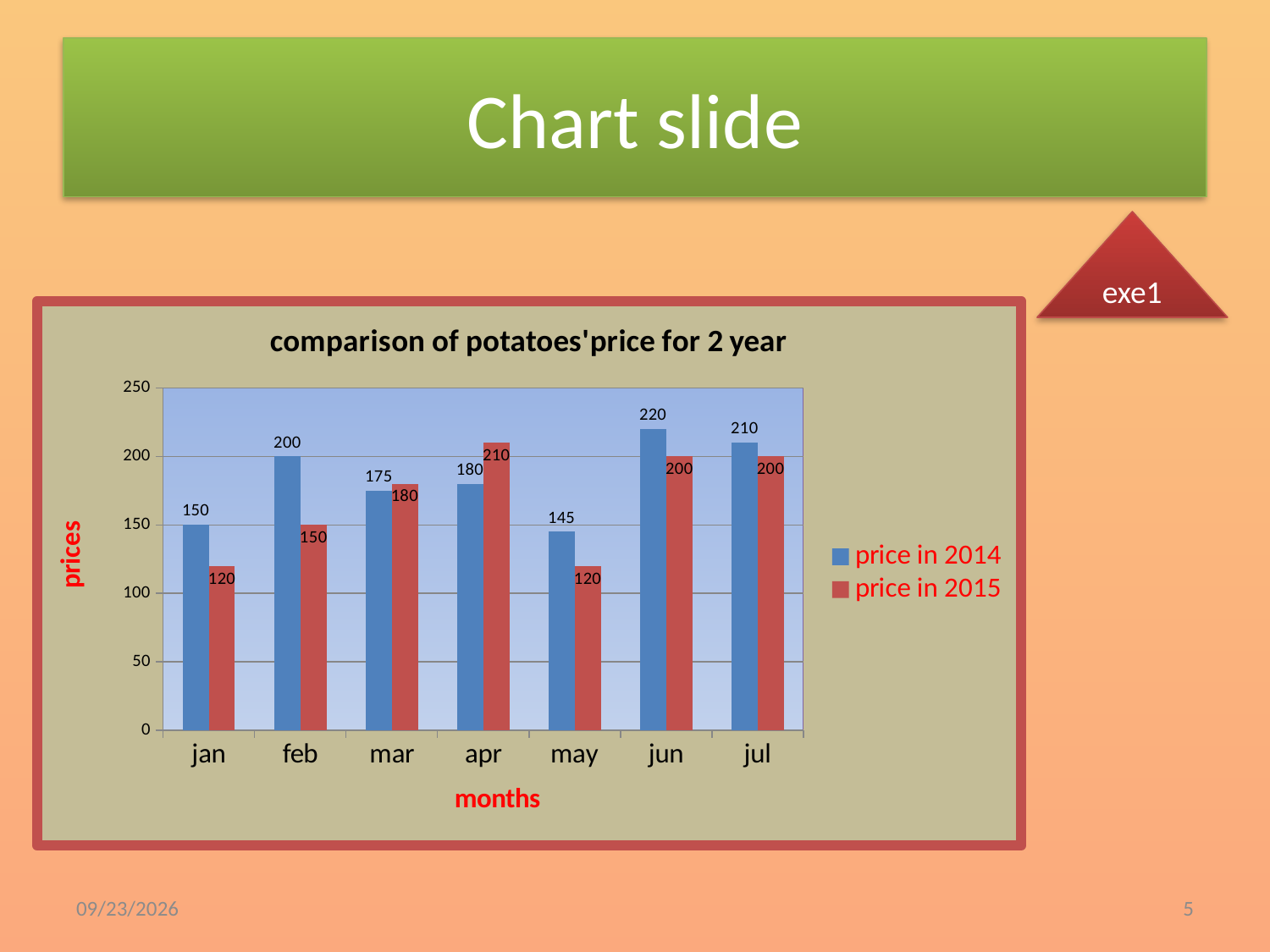
What is the title of the chart? comparison of potatoes'price for 2 year What is the label of the y axis? prices What kind of chart is shown on the slide? bar chart Which month has the highest price in 2014? jun What is the price in 2015 for may? 120 What is the price in 2015 for apr? 210 Which is larger for mar, the price in 2014 or the price in 2015? price in 2015 What is the price in 2014 for jan? 150 Which month has the lowest price in 2014? may What is the difference between the price in 2014 and the price in 2015 for feb? 50 How many months are shown on the x axis? 7 How many series does the legend list? 2